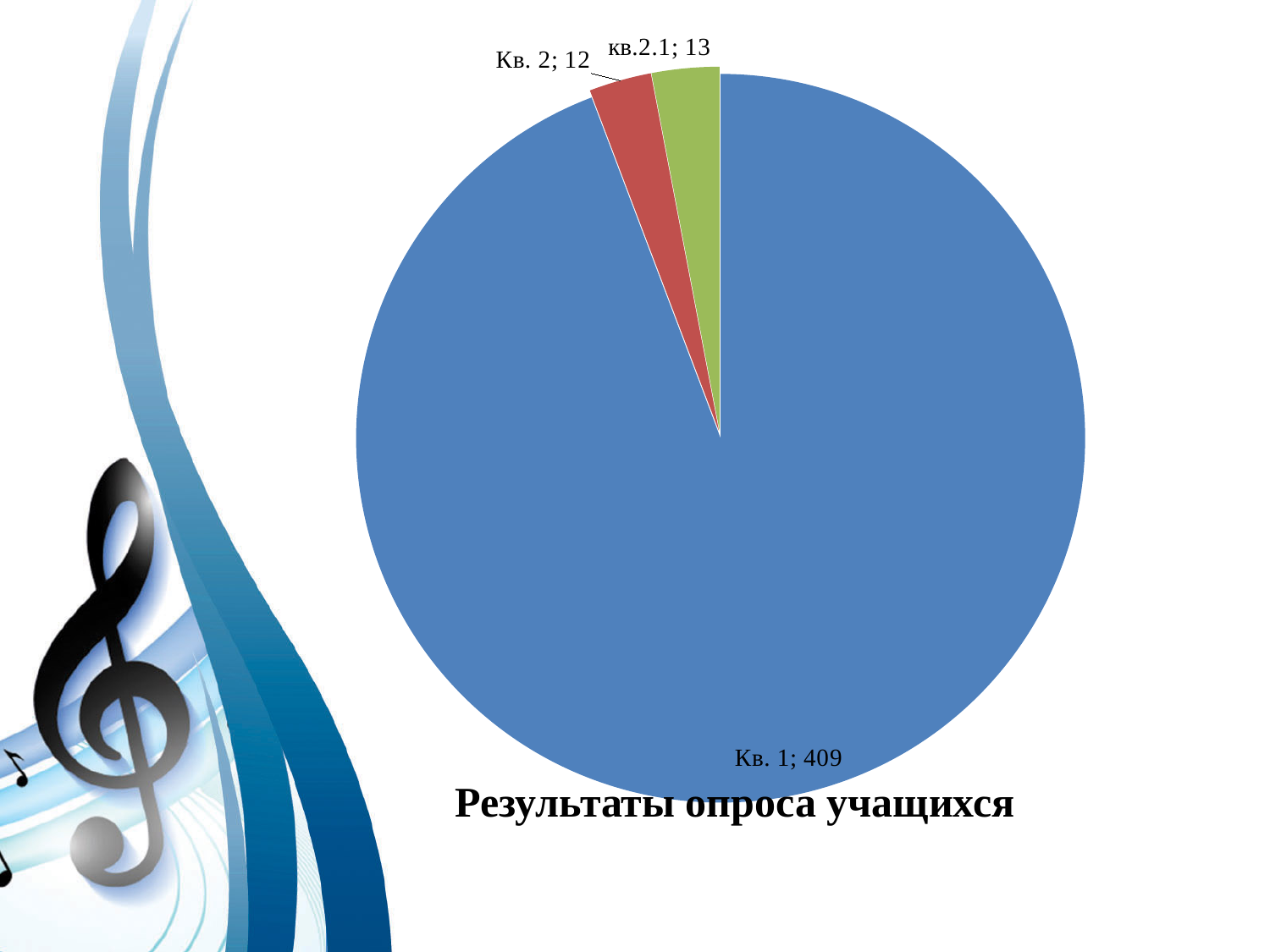
What is the total of all three slices? 434 Which category has the largest slice? Кв. 1 What colour is the slice for Кв. 1? blue What is the value for кв.2.1? 13 What is the value for Кв. 2? 12 What kind of chart is shown on the slide? pie chart What is the title of the chart? Результаты опроса учащихся Which category has the smallest value? Кв. 2 Which is larger, the value for Кв. 2 or the value for кв.2.1? кв.2.1 What is the difference between the values for Кв. 1 and кв.2.1? 396 How many slices does the pie chart have? 3 What is the value for Кв. 1? 409